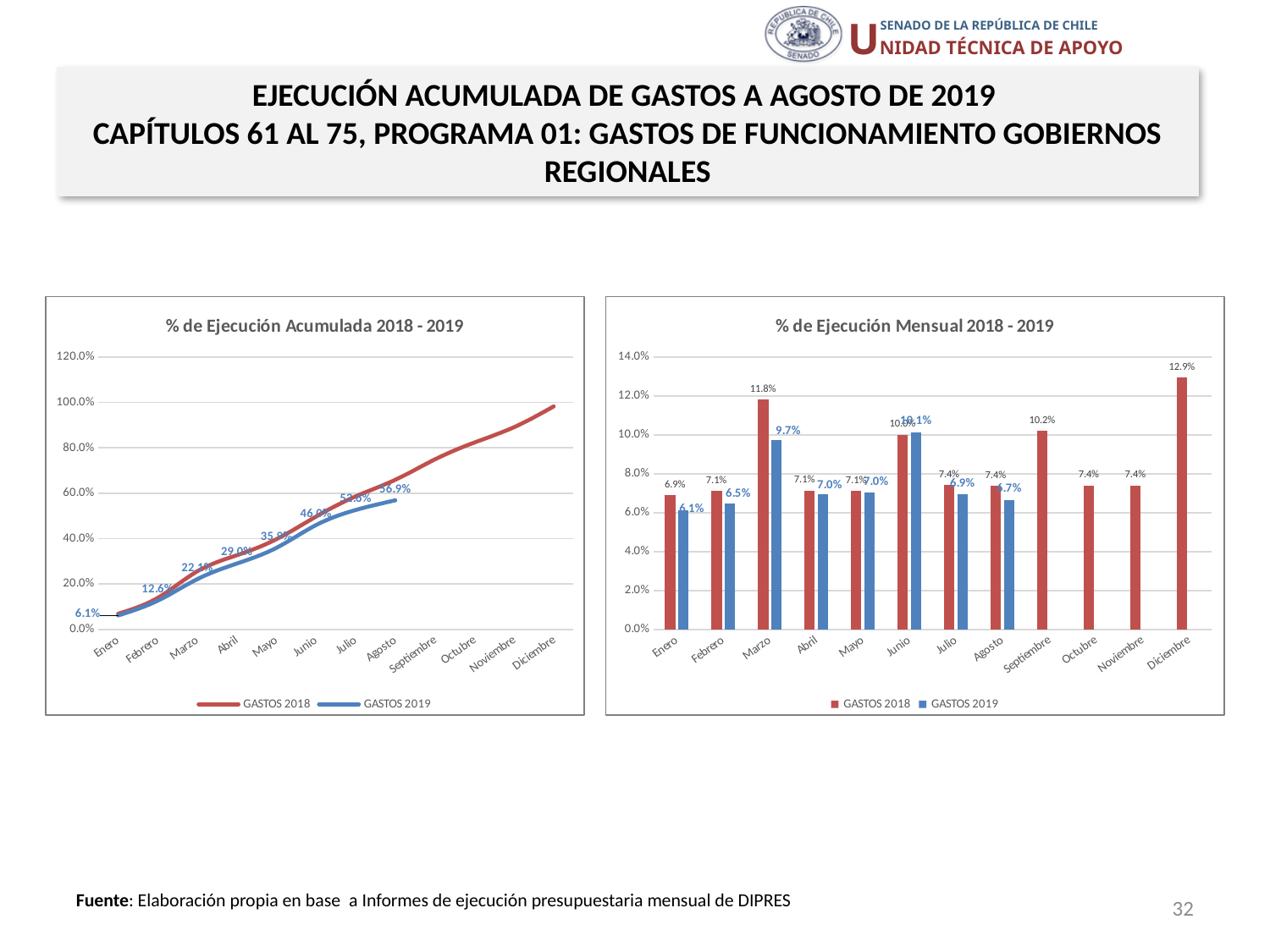
What kind of chart is the right chart titled '% de Ejecución Mensual 2018 - 2019'? Bar chart In the '% de Ejecución Mensual 2018 - 2019' chart, which month has the lowest GASTOS 2019 value? Enero In the '% de Ejecución Mensual 2018 - 2019' chart, which is larger for Febrero: GASTOS 2018 or GASTOS 2019? GASTOS 2018 In the '% de Ejecución Mensual 2018 - 2019' chart, what is the GASTOS 2018 value for Diciembre? 12.9% What kind of chart is the left chart titled '% de Ejecución Acumulada 2018 - 2019'? Line chart In the '% de Ejecución Mensual 2018 - 2019' chart, what is the difference between the GASTOS 2018 and GASTOS 2019 values for Marzo? 2.1 percentage points In the '% de Ejecución Acumulada 2018 - 2019' chart, does the GASTOS 2018 line rise or fall from Enero to Diciembre? Rises In the '% de Ejecución Acumulada 2018 - 2019' chart, is the GASTOS 2018 value for Diciembre greater or less than 80%? greater In the '% de Ejecución Acumulada 2018 - 2019' chart, what is the GASTOS 2019 value for Agosto? 56.9% In the '% de Ejecución Mensual 2018 - 2019' chart, which month has the highest GASTOS 2018 value? Diciembre How many series does the legend of the '% de Ejecución Mensual 2018 - 2019' chart list? 2 In the '% de Ejecución Mensual 2018 - 2019' chart, what is the GASTOS 2019 value for Marzo? 9.7%